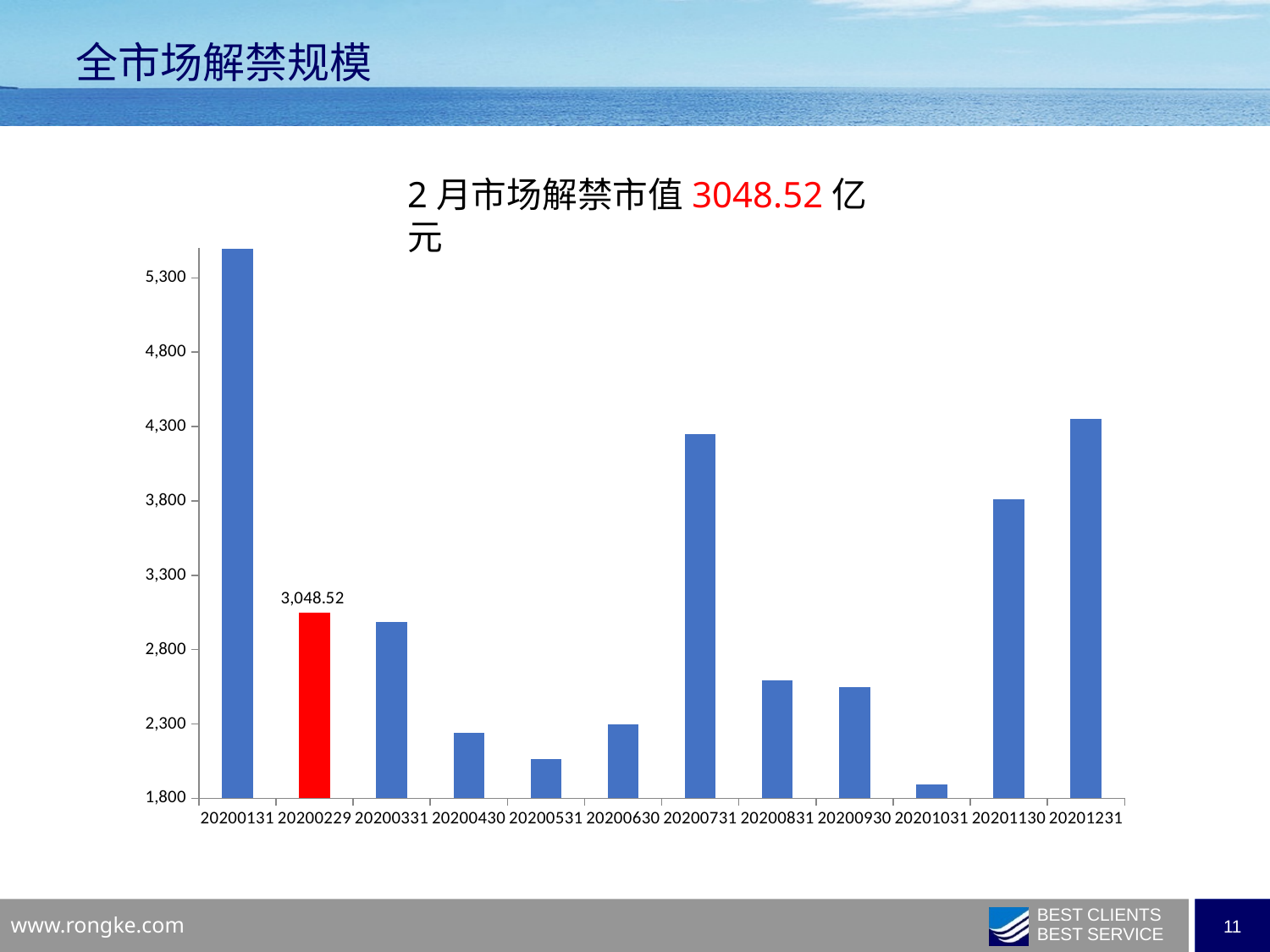
How many categories are shown on the x axis? 12 Which category's bar is coloured red? 20200229 What is the title of the slide? 全市场解禁规模 Which is larger, the value for 20201231 or the value for 20200831? 20201231 Is the value for 20200531 greater or less than 2,300? less Which category has the lowest value? 20201031 Which is larger, the value for 20200131 or the value for 20201231? 20200131 What kind of chart is shown on the slide? Bar chart Which category has the highest value? 20200131 Is the value for 20200731 greater or less than 3,800? greater Is the value for 20201130 greater or less than 3,300? greater What is the value for 20200229? 3,048.52